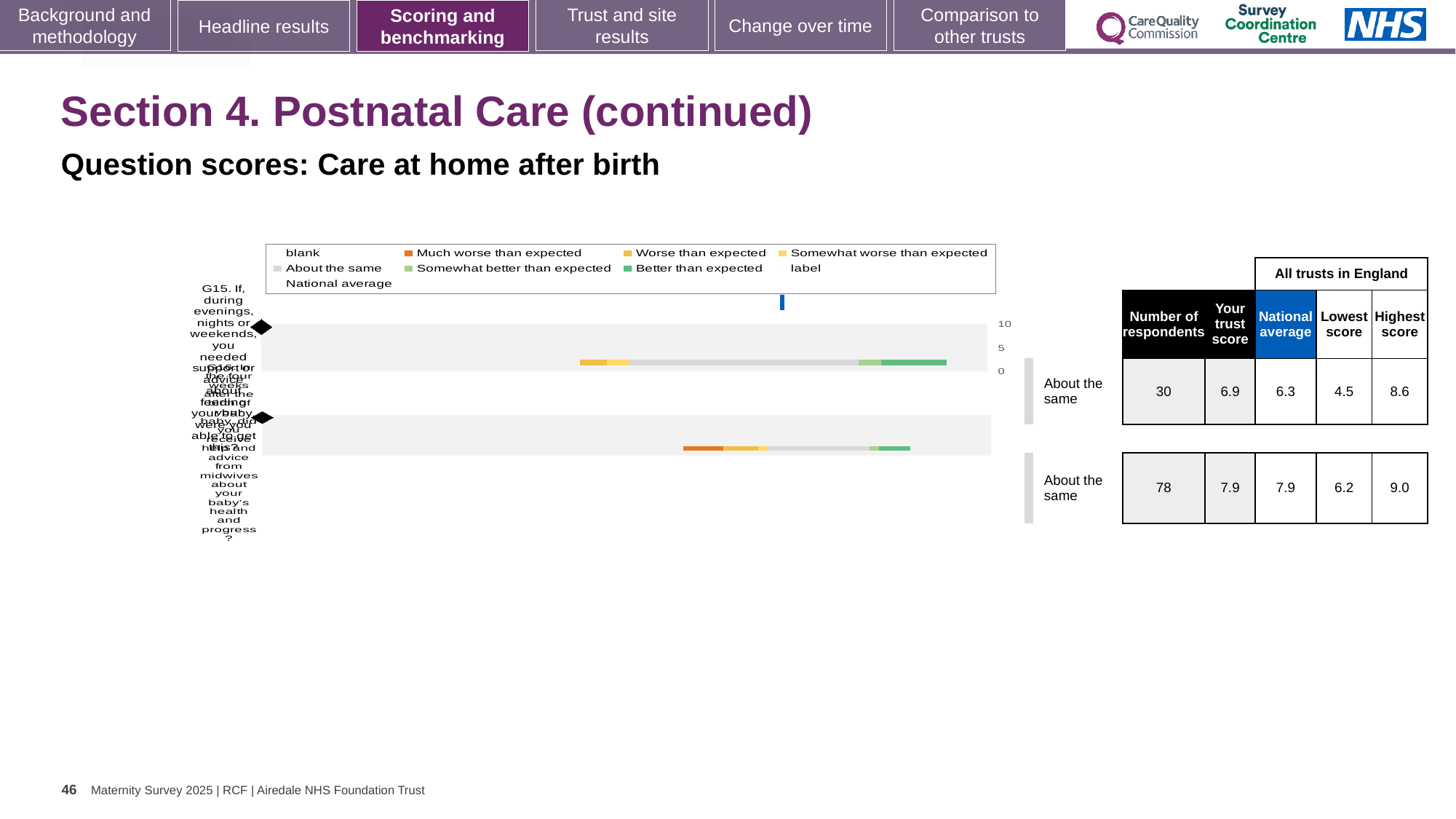
What kind of chart is shown on the slide? Bar chart For the first (top) question, how much higher is the trust score than the national average? 0.6 In the table next to the chart, what is the national average for the first (top) question? 6.3 In the table next to the chart, what is the number of respondents for the first (top) question? 30 How many question bars are plotted in the chart? 2 In the table next to the chart, what is the lowest score for the second (bottom) question? 6.2 For the first (top) question, what is the difference between the highest score and the lowest score? 4.1 Which question row has more respondents, the first or the second? The second (78) In the table next to the chart, what is the trust score for the first (top) question? 6.9 What colour does the legend use for 'Much worse than expected'? Orange What benchmark category label is shown beside both bars in the chart? About the same In the table next to the chart, what is the highest score for the second (bottom) question? 9.0